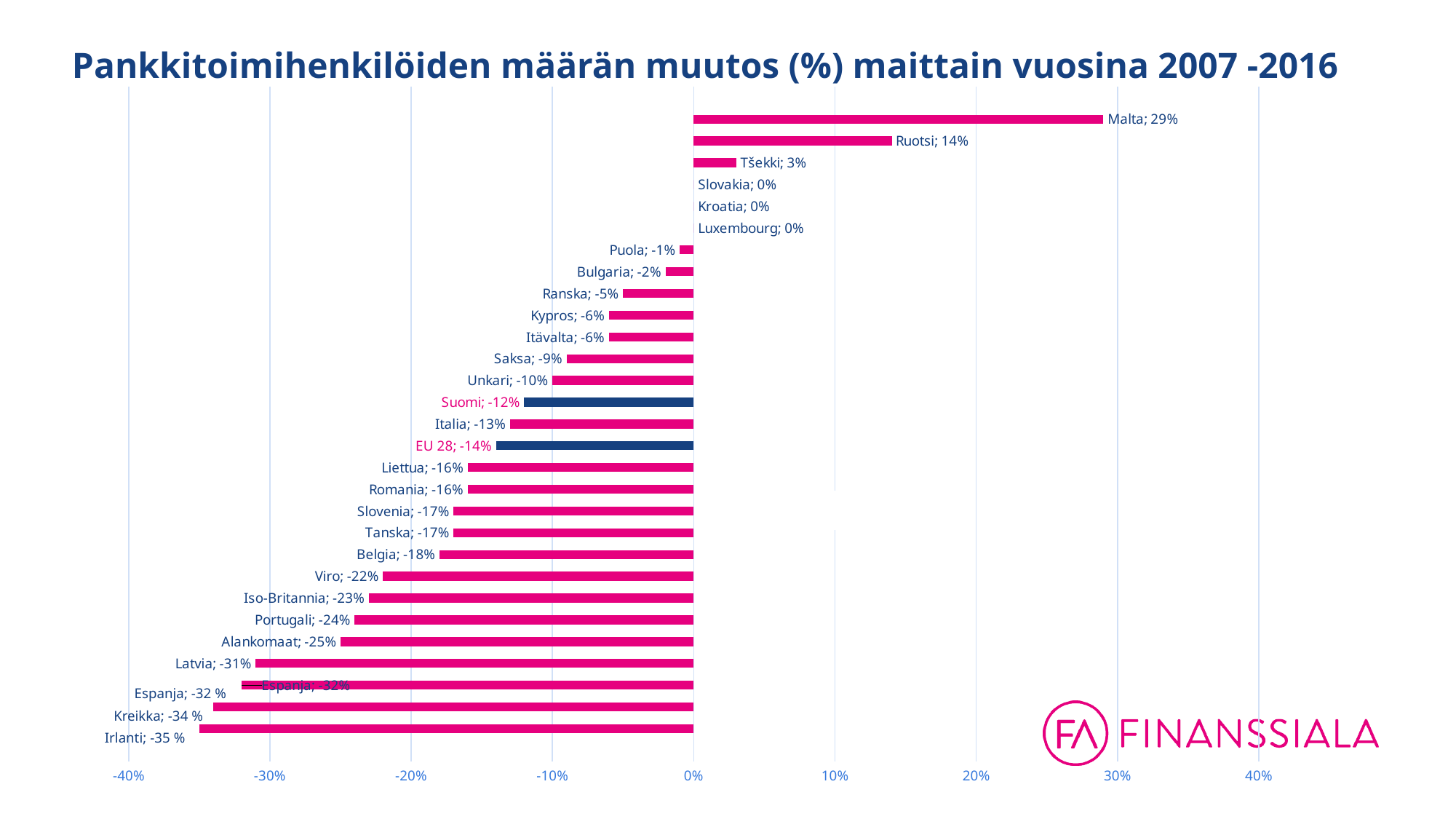
Which two bars are coloured dark blue instead of pink? Suomi and EU 28 What is the value for Suomi? -12% Which has the larger value, Saksa or Unkari? Saksa Which country has the highest value? Malta What is the difference between the values for Suomi and EU 28? 2 percentage points What is the value for Irlanti? -35 % What is the value for Malta? 29% Which country has the lowest value? Irlanti What kind of chart is shown on the slide? Bar chart What is the difference between the values for Malta and Ruotsi? 15 percentage points Which has the larger value, Ruotsi or Tšekki? Ruotsi What is the value for EU 28? -14%